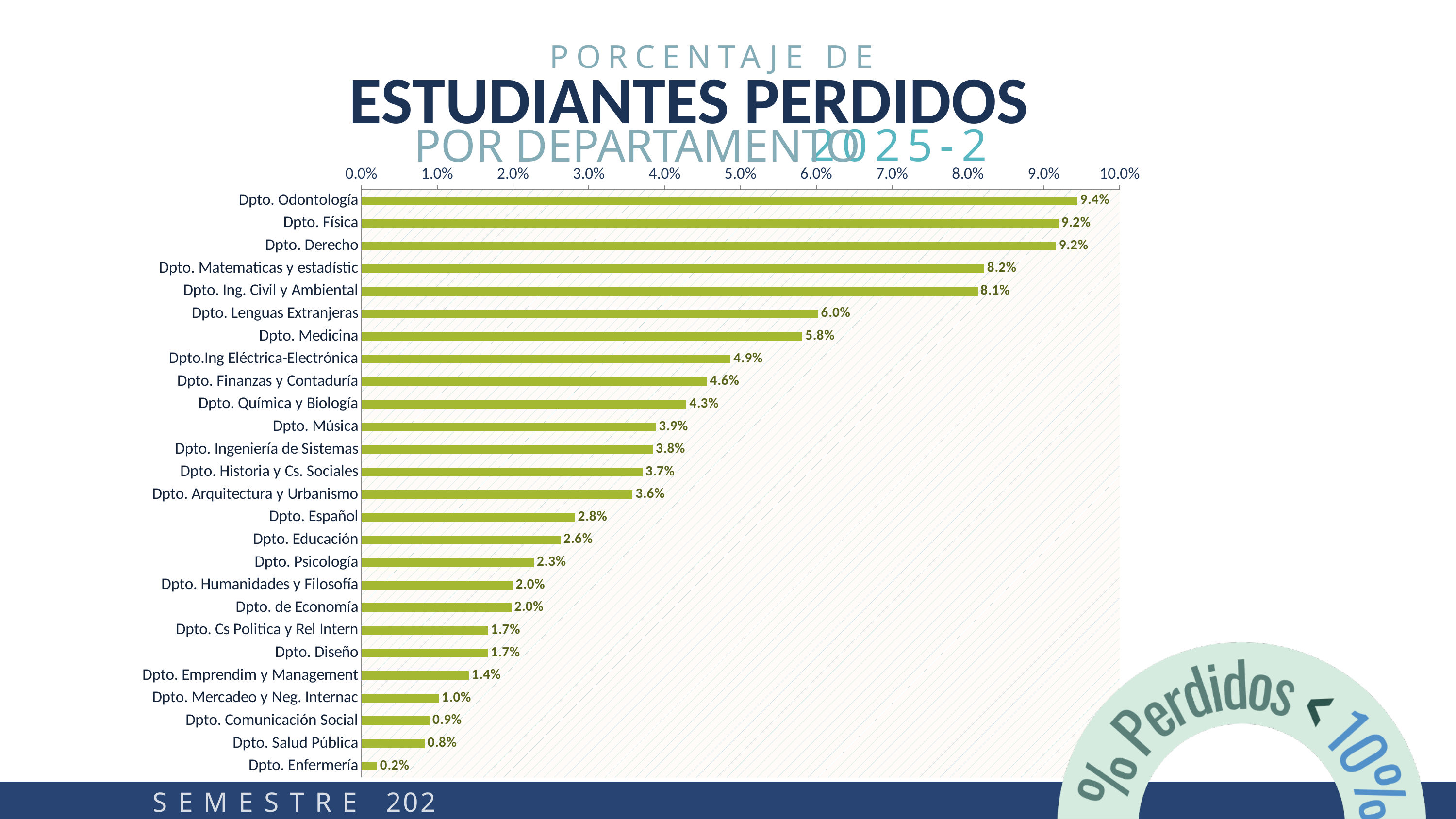
What is the value for Dpto. Psicología? 2.3% Which is larger, the value for Dpto. Música or the value for Dpto. Español? Dpto. Música What is the difference between the values for Dpto. Odontología and Dpto. Enfermería? 9.2% How many departments are shown in the chart? 26 What is the maximum value shown on the horizontal axis? 10.0% What is the difference between the values for Dpto. Lenguas Extranjeras and Dpto. Medicina? 0.2% What is the value for Dpto. Odontología? 9.4% Which department has the lowest percentage of lost students? Dpto. Enfermería Is the value for Dpto. Ing. Civil y Ambiental greater or less than 8.0%? greater Which department has the highest percentage of lost students? Dpto. Odontología What kind of chart is shown on the slide? bar chart What is the value for Dpto. Medicina? 5.8%